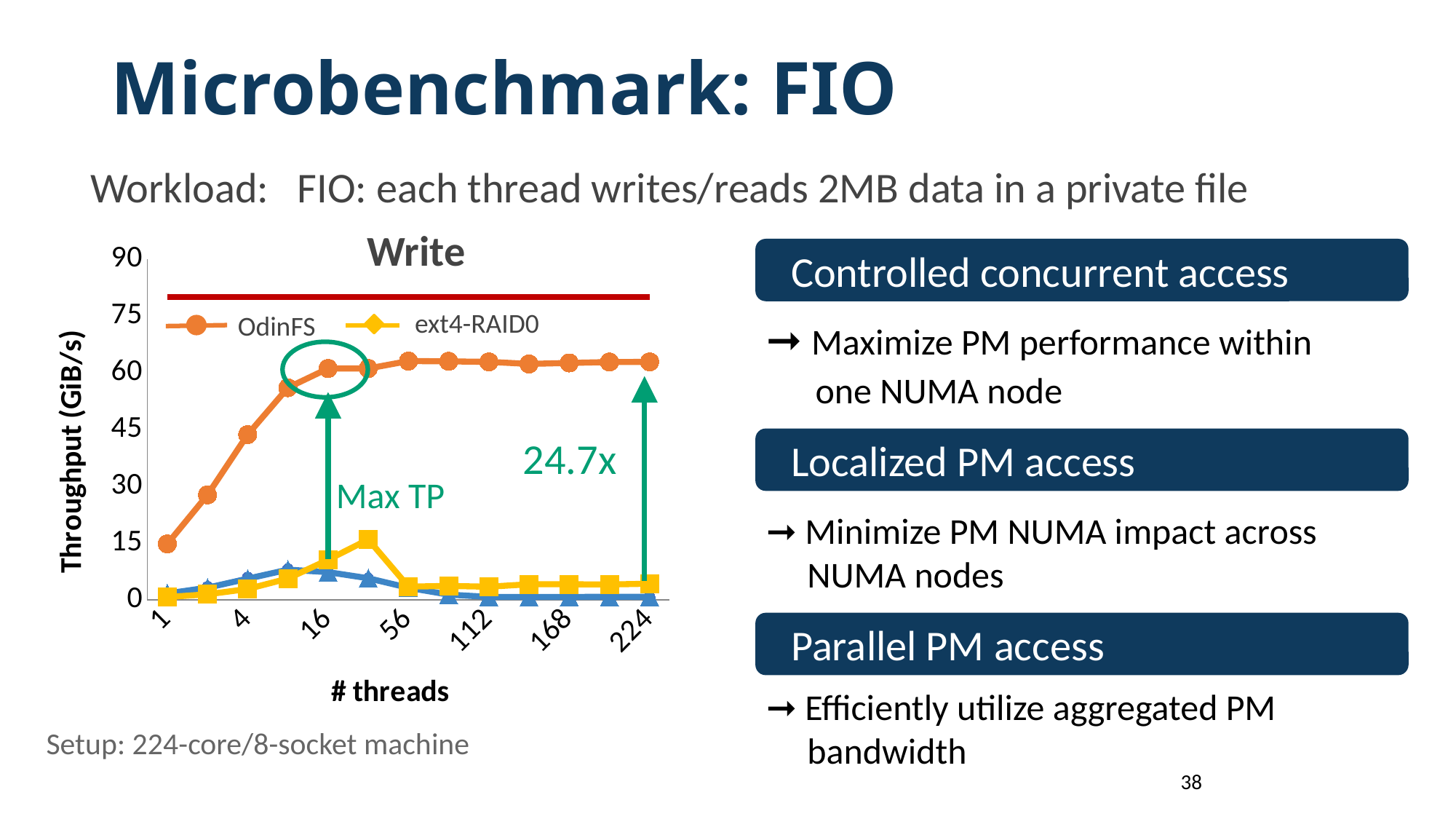
At 224 threads, which series has the higher throughput, OdinFS or ext4-RAID0? OdinFS Is the OdinFS throughput at 1 thread greater or less than 30 GiB/s? less What speedup factor is annotated on the chart at 224 threads? 24.7x Which series reaches the highest throughput in the chart? OdinFS What kind of chart is shown on the slide? line chart What is the title of the chart? Write Is the ext4-RAID0 throughput at 224 threads greater or less than 15 GiB/s? less Is the ext4-RAID0 throughput at 16 threads greater or less than 30 GiB/s? less How many series does the chart's legend list? 2 Does the OdinFS throughput rise or fall as the number of threads increases from 1 to 16? rise How many tick labels are shown on the x axis (# threads)? 7